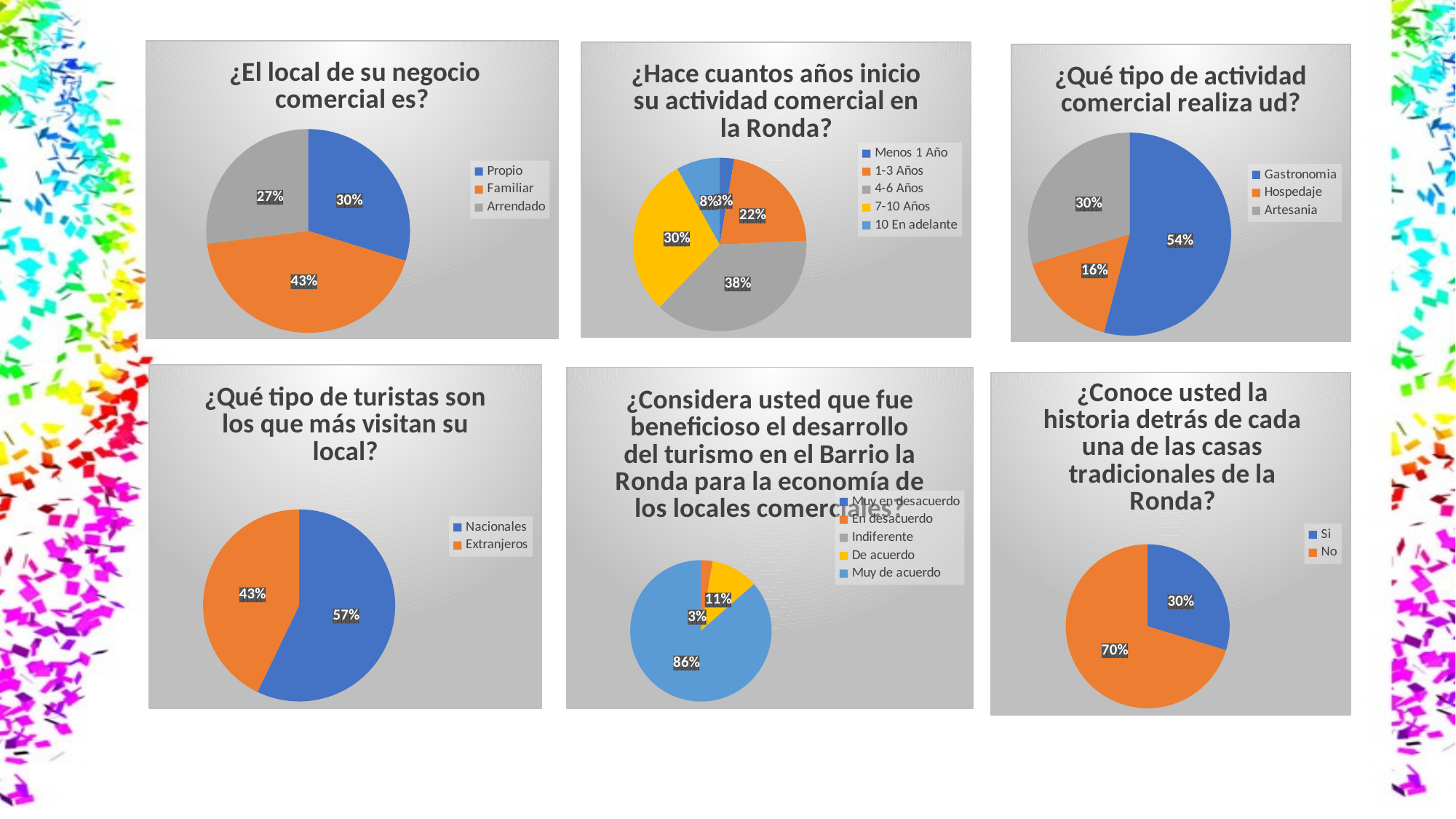
In the chart titled '¿El local de su negocio comercial es?', what percentage is shown for Familiar? 43% In the chart titled '¿Qué tipo de actividad comercial realiza ud?', what percentage is shown for Hospedaje? 16% In the chart titled '¿Hace cuantos años inicio su actividad comercial en la Ronda?', how many categories does the legend list? 5 In the chart titled '¿Qué tipo de turistas son los que más visitan su local?', what is the difference between Nacionales and Extranjeros? 14% In the chart titled '¿El local de su negocio comercial es?', which category has the smallest share? Arrendado What type of chart is used for '¿Conoce usted la historia detrás de cada una de las casas tradicionales de la Ronda?'? Pie chart In the chart titled '¿Qué tipo de actividad comercial realiza ud?', which category has the largest share? Gastronomia In the chart titled '¿Hace cuantos años inicio su actividad comercial en la Ronda?', what percentage is shown for 4-6 Años? 38% In the chart titled '¿Considera usted que fue beneficioso el desarrollo del turismo en el Barrio la Ronda para la economía de los locales comerciales?', what percentage is shown for Muy de acuerdo? 86% In the chart titled '¿Hace cuantos años inicio su actividad comercial en la Ronda?', what is the difference between the 7-10 Años share and the 1-3 Años share? 8% In the chart titled '¿Qué tipo de turistas son los que más visitan su local?', which is larger, Nacionales or Extranjeros? Nacionales In the chart titled '¿Conoce usted la historia detrás de cada una de las casas tradicionales de la Ronda?', what percentage answered No? 70%